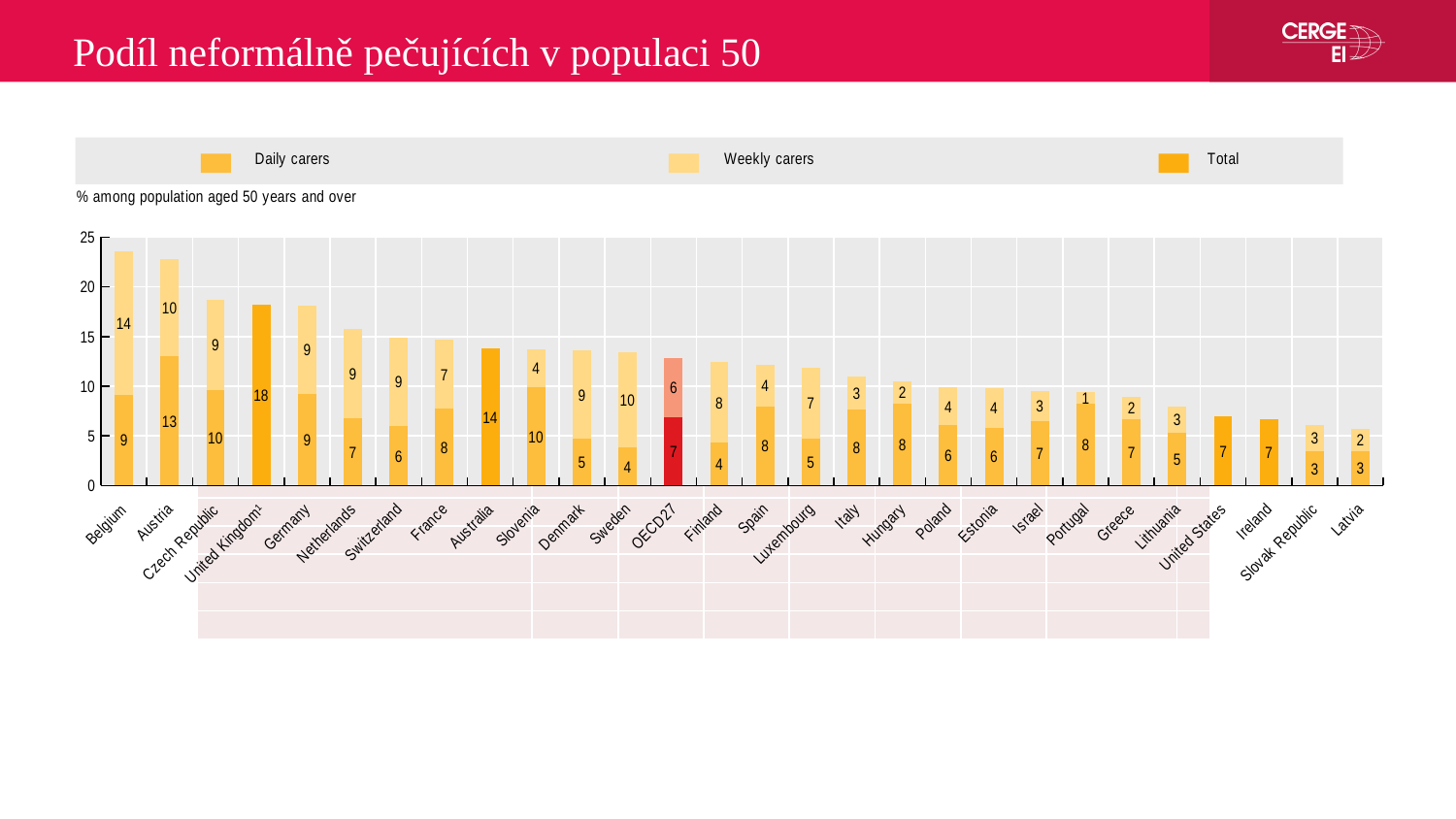
What is the combined total of the stacked bar for OECD27? 13 How many series does the legend list? 3 What is the value for Daily carers in Belgium? 9 What is the combined total of the stacked bar for Belgium? 23 How many countries or groups are shown on the x axis? 28 What is the value for Weekly carers in Austria? 10 Which is larger, the Daily carers value for Slovenia or for Sweden? Slovenia What is the difference between Weekly carers and Daily carers in Belgium? 5 What is the Total value shown for United Kingdom? 18 What is the value for Weekly carers in Sweden? 10 Is the Total value for United Kingdom greater or less than 15? greater What kind of chart is shown on the slide? Stacked bar chart